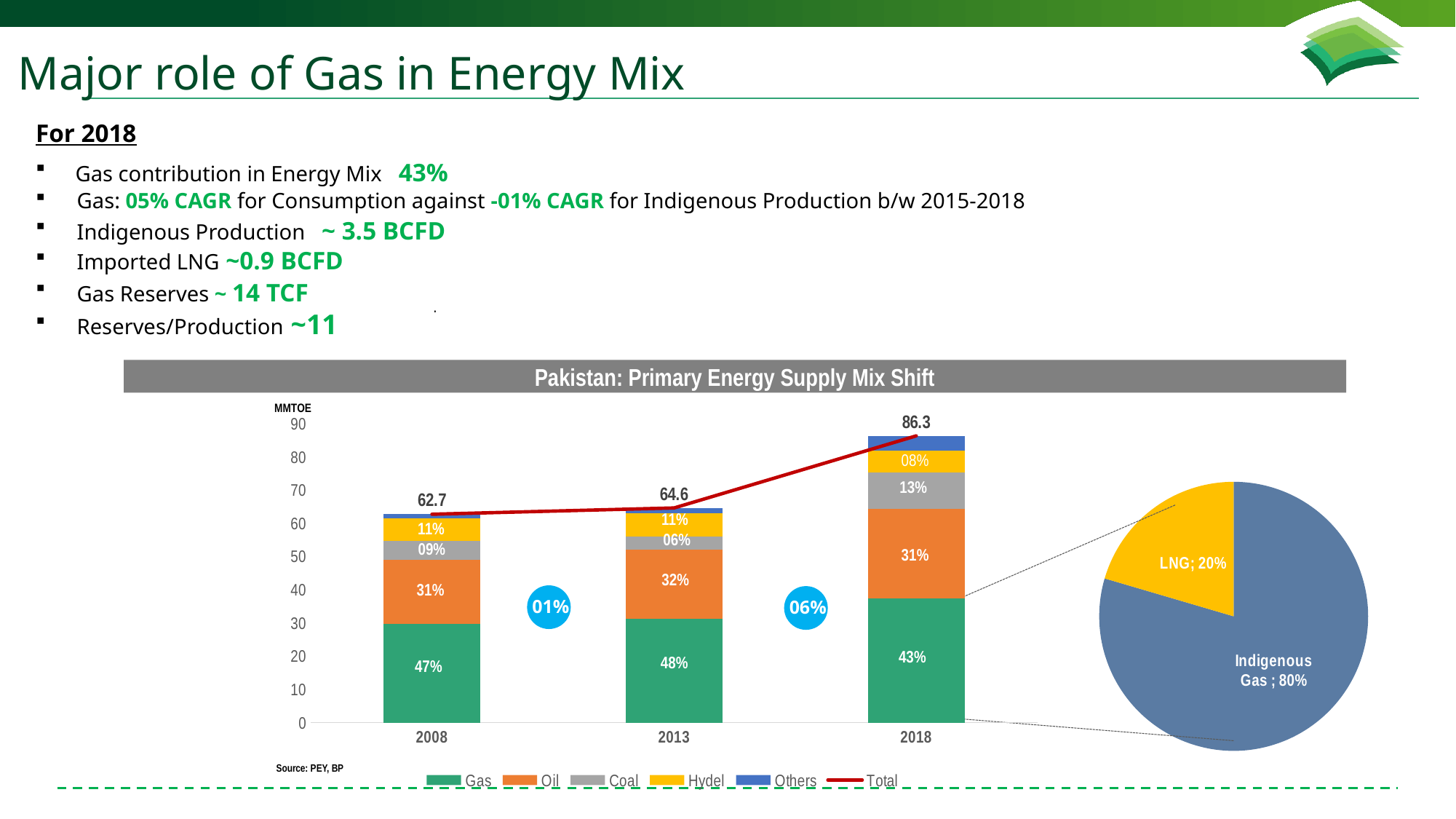
In the pie chart on the right, which slice is larger, LNG or Indigenous Gas? Indigenous Gas In the 'Pakistan: Primary Energy Supply Mix Shift' chart, is the Gas share larger in 2008 or in 2018? 2008 In the 'Pakistan: Primary Energy Supply Mix Shift' chart, what is the Coal share in 2018? 13% In the 'Pakistan: Primary Energy Supply Mix Shift' chart, how many years are shown on the x axis? 3 What kind of chart is the 'Pakistan: Primary Energy Supply Mix Shift' chart? Stacked bar chart with a total line In the 'Pakistan: Primary Energy Supply Mix Shift' chart, what is the difference between the total for 2018 and the total for 2008? 23.6 In the 'Pakistan: Primary Energy Supply Mix Shift' chart, how many entries does the legend list? 6 In the 'Pakistan: Primary Energy Supply Mix Shift' chart, does the Total line rise or fall from 2008 to 2018? Rises In the 'Pakistan: Primary Energy Supply Mix Shift' chart, what is the total energy supply (MMTOE) for 2018? 86.3 In the 'Pakistan: Primary Energy Supply Mix Shift' chart, which year has the highest total energy supply? 2018 In the pie chart on the right, what share does LNG have? 20% In the 'Pakistan: Primary Energy Supply Mix Shift' chart, what percentage share does Gas have in 2013? 48%